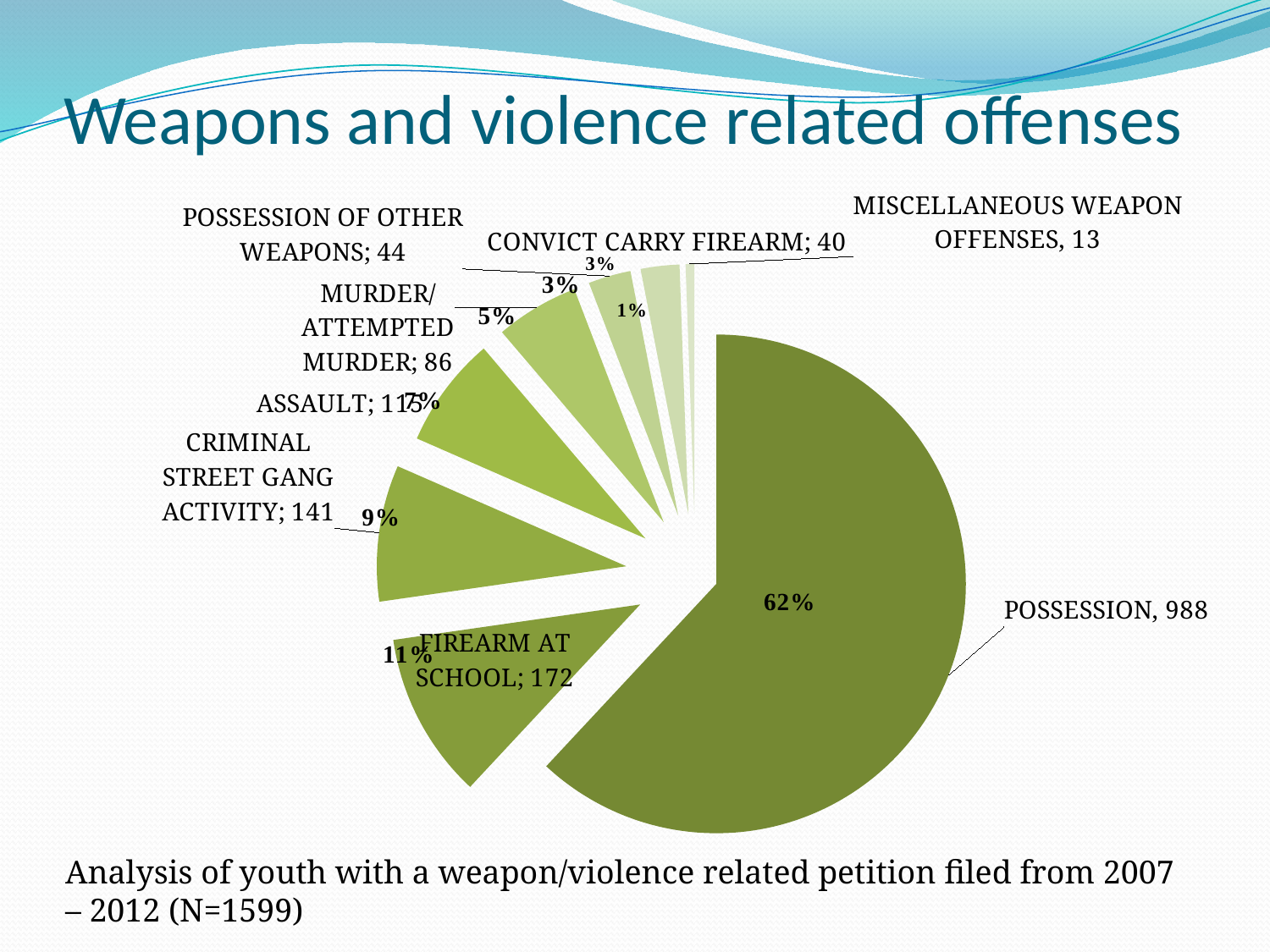
What is the value for MURDER/ATTEMPTED MURDER? 86 Which is larger, the value for POSSESSION OF OTHER WEAPONS or the value for CONVICT CARRY FIREARM? POSSESSION OF OTHER WEAPONS What is the difference between the values for POSSESSION and FIREARM AT SCHOOL? 816 What is the value for FIREARM AT SCHOOL? 172 What is the value for MISCELLANEOUS WEAPON OFFENSES? 13 Which category has the smallest slice of the pie? MISCELLANEOUS WEAPON OFFENSES What share of the pie does POSSESSION represent? 62% What share of the pie does FIREARM AT SCHOOL represent? 11% What is the value for CRIMINAL STREET GANG ACTIVITY? 141 Which category has the largest slice of the pie? POSSESSION What is the value for POSSESSION? 988 What kind of chart is shown on the slide? pie chart